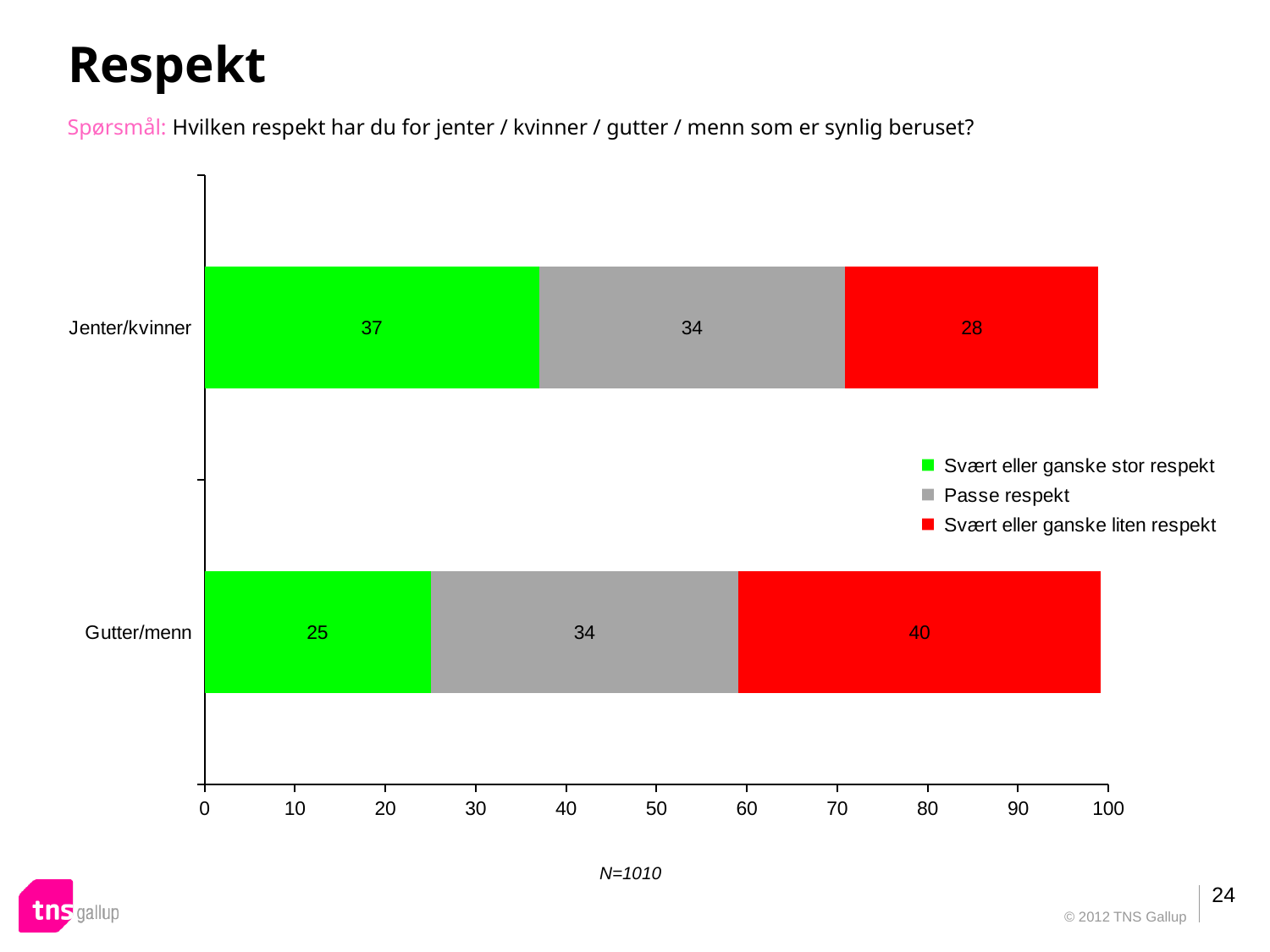
How many categories are shown on the chart? 2 What is the value for "Svært eller ganske stor respekt" for Jenter/kvinner? 37 What is the total of the stacked bar for Gutter/menn? 99 What kind of chart is shown on the slide? Stacked bar chart What is the value for "Svært eller ganske stor respekt" for Gutter/menn? 25 What is the difference between the "Svært eller ganske stor respekt" values for Jenter/kvinner and Gutter/menn? 12 What is the value for "Passe respekt" for Jenter/kvinner? 34 How many series does the legend list? 3 What is the difference between the "Svært eller ganske liten respekt" values for Gutter/menn and Jenter/kvinner? 12 What is the total of the stacked bar for Jenter/kvinner? 99 What is the value for "Svært eller ganske liten respekt" for Gutter/menn? 40 Which category has the higher value for "Svært eller ganske liten respekt", Jenter/kvinner or Gutter/menn? Gutter/menn